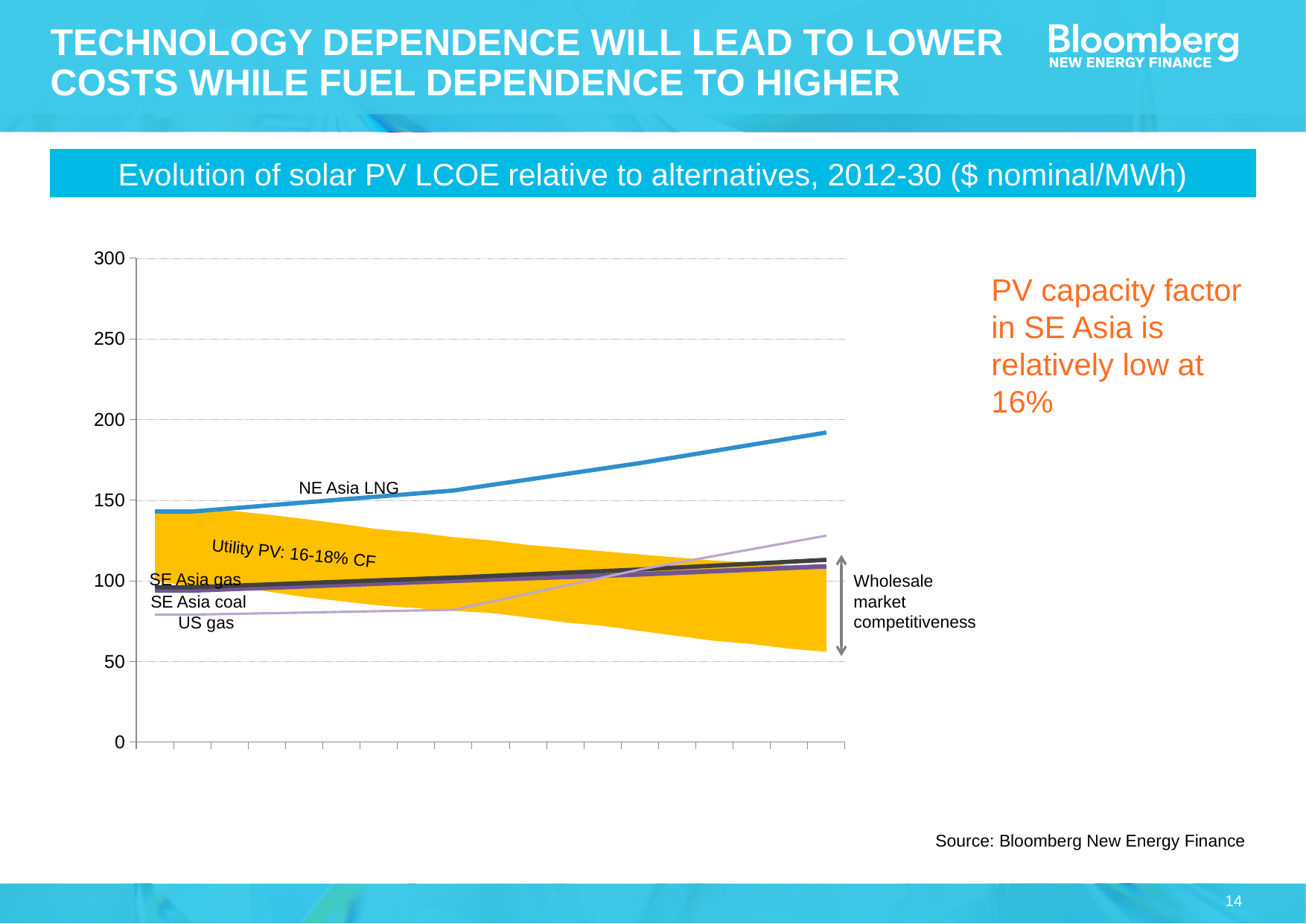
Is the value for US gas at the left end of the chart greater or less than 100? less Does the US gas line rise or fall from left to right? rise Which labelled series is highest at the right end of the chart? NE Asia LNG Does the NE Asia LNG line rise or fall from left to right? rise Is the value for US gas at the right end of the chart greater or less than 100? greater What is the highest value shown on the y axis? 300 What kind of chart is shown on the slide? combination area and line chart What is the title of the chart? Evolution of solar PV LCOE relative to alternatives, 2012-30 ($ nominal/MWh) Does the Utility PV band move up or down from left to right? down Is the value for NE Asia LNG at the right end of the chart greater or less than 150? greater At the left end of the chart, which is higher: NE Asia LNG or SE Asia coal? NE Asia LNG Which labelled line is lowest at the left end of the chart? US gas